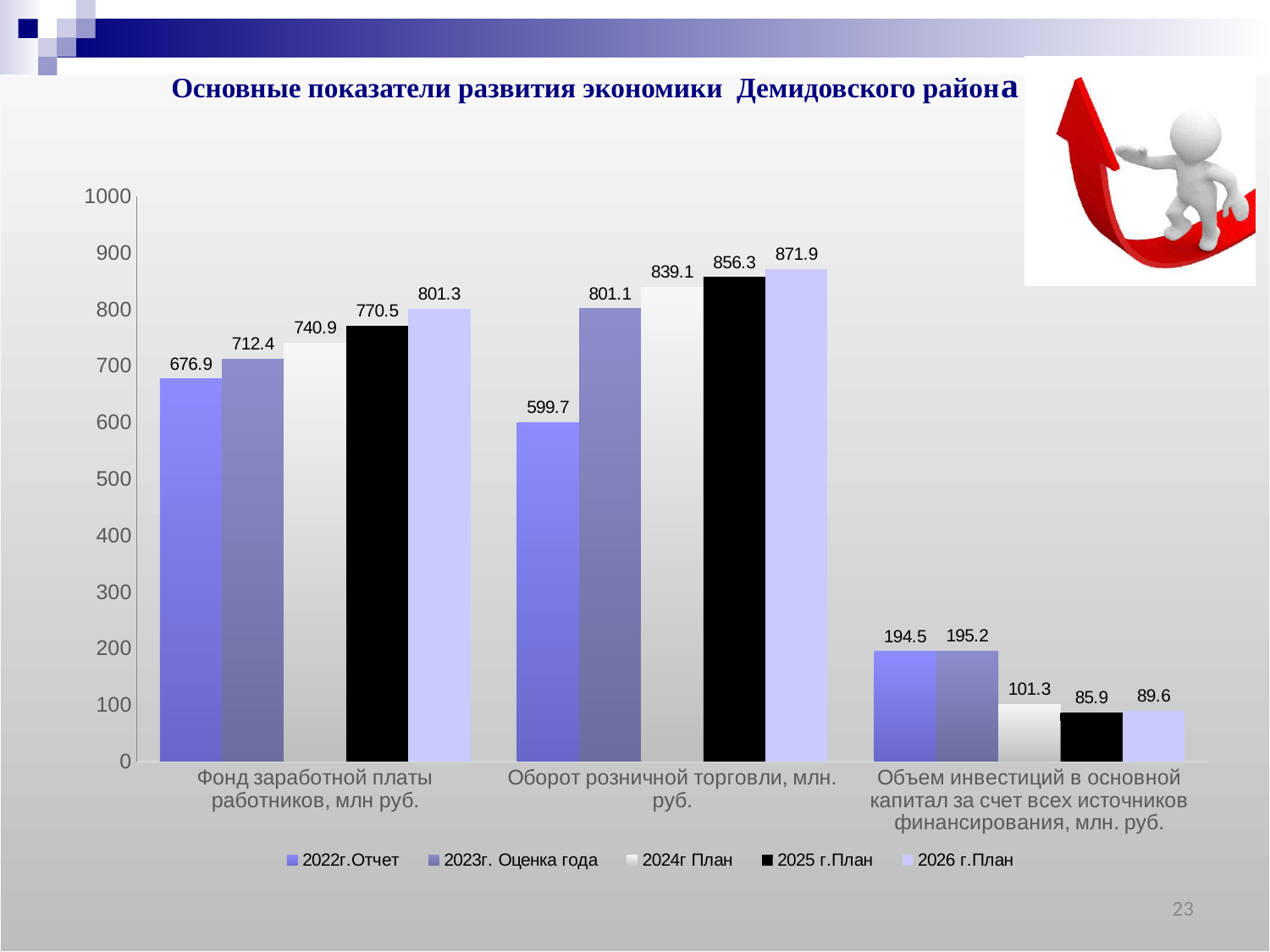
Which series has the highest value in the category Оборот розничной торговли, млн. руб.? 2026 г.План Which is larger for 2023г. Оценка года: Фонд заработной платы работников or Оборот розничной торговли? Оборот розничной торговли What is the value for 2024г План in the category Объем инвестиций в основной капитал за счет всех источников финансирования, млн. руб.? 101.3 How many series does the legend list? 5 Which series has the lowest value in the category Объем инвестиций в основной капитал за счет всех источников финансирования, млн. руб.? 2025 г.План What is the difference between the 2026 г.План and 2022г.Отчет values for Фонд заработной платы работников, млн руб.? 124.4 What is the value for 2022г.Отчет in the category Фонд заработной платы работников, млн руб.? 676.9 Is the 2022г.Отчет value for Оборот розничной торговли, млн. руб. greater or less than 600? less How many categories are shown on the x axis? 3 What kind of chart is shown on the slide? bar chart What is the value for 2026 г.План in the category Оборот розничной торговли, млн. руб.? 871.9 Do the values for Фонд заработной платы работников, млн руб. rise or fall from 2022г.Отчет to 2026 г.План? rise